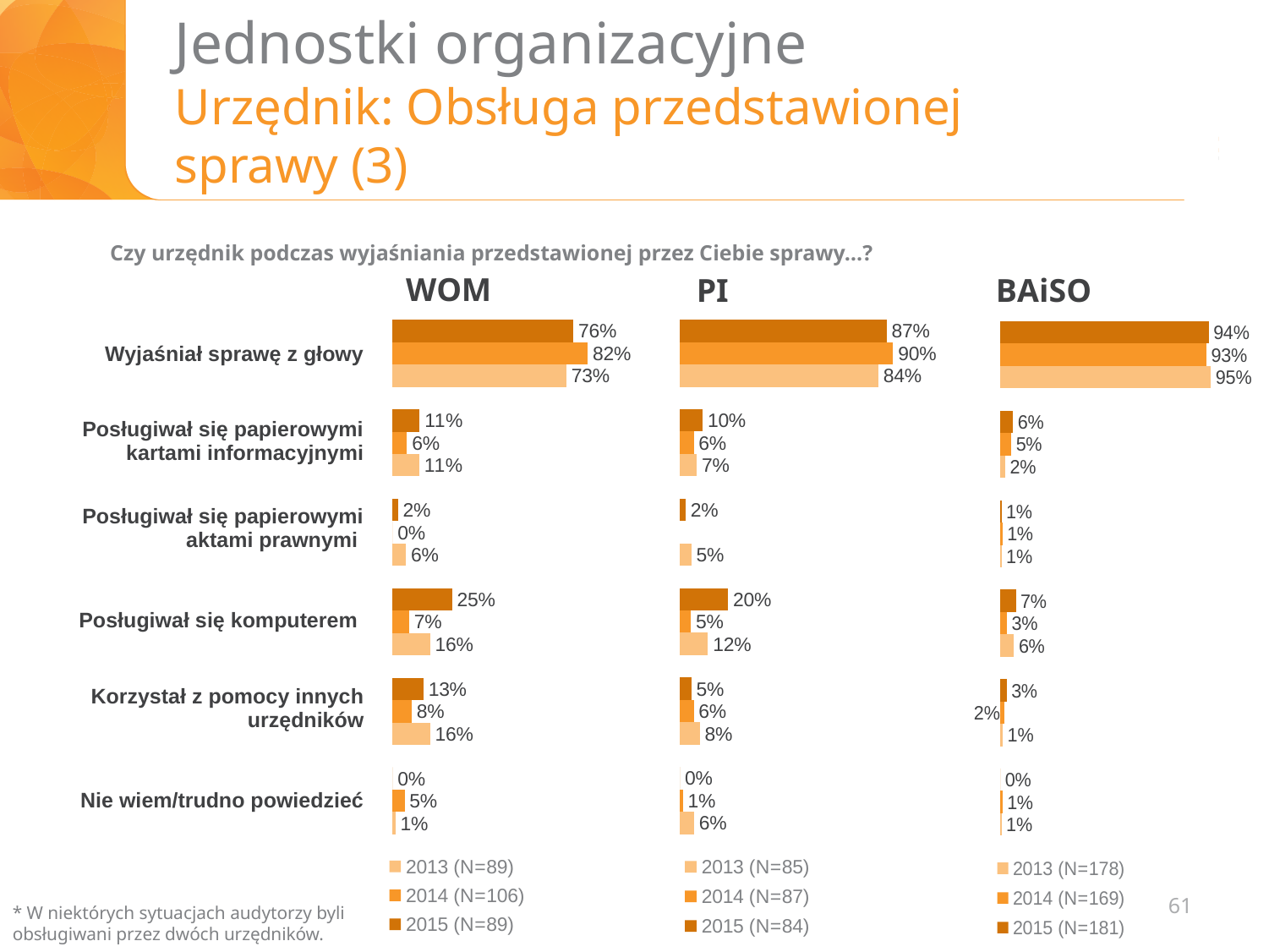
What is the sample size (N) for 2014 in the BAiSO chart legend? 169 What kind of chart is the PI chart? bar chart How many categories are shown in the BAiSO chart? 6 In the WOM chart, which category has the highest value in 2015 (N=89)? Wyjaśniał sprawę z głowy In the PI chart, what is the value for 'Posługiwał się komputerem' in 2015 (N=84)? 20% In the WOM chart, what is the value for 'Wyjaśniał sprawę z głowy' in 2014 (N=106)? 82% How many series does the legend of the WOM chart list? 3 In the WOM chart, what is the difference between the 2015 and 2014 values for 'Posługiwał się komputerem'? 18% In the BAiSO chart, what is the difference between the 2015 and 2013 values for 'Posługiwał się papierowymi kartami informacyjnymi'? 4% In the PI chart, which category has the lowest value in 2015 (N=84)? Nie wiem/trudno powiedzieć In the PI chart, which is larger for 'Wyjaśniał sprawę z głowy': the 2014 value or the 2013 value? 2014 In the BAiSO chart, what is the value for 'Wyjaśniał sprawę z głowy' in 2013 (N=178)? 95%